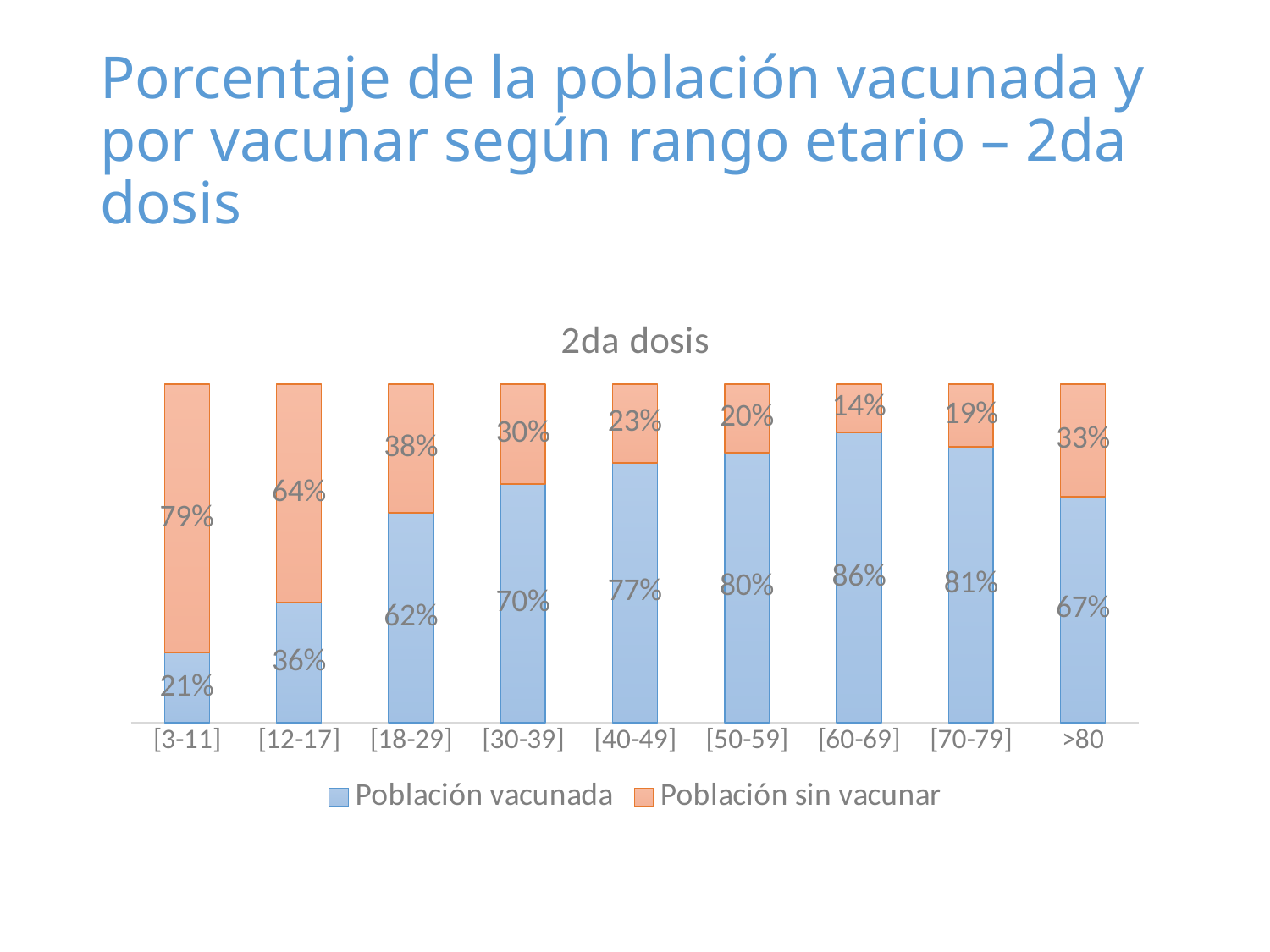
What is the value of Población sin vacunar for the [18-29] age group? 38% How many age groups are shown on the x axis? 9 Which age group has the highest Población vacunada value? [60-69] What is the value of Población sin vacunar for the >80 age group? 33% What kind of chart is shown on the slide? Stacked bar chart What is the difference between the Población vacunada values for [50-59] and [12-17]? 44% What is the value of Población vacunada for the [3-11] age group? 21% What is the title shown above the chart? 2da dosis Which is larger, the Población sin vacunar value for [30-39] or for [70-79]? [30-39] What is the value of Población vacunada for the [60-69] age group? 86% How many series does the legend list? 2 Which age group has the lowest Población vacunada value? [3-11]